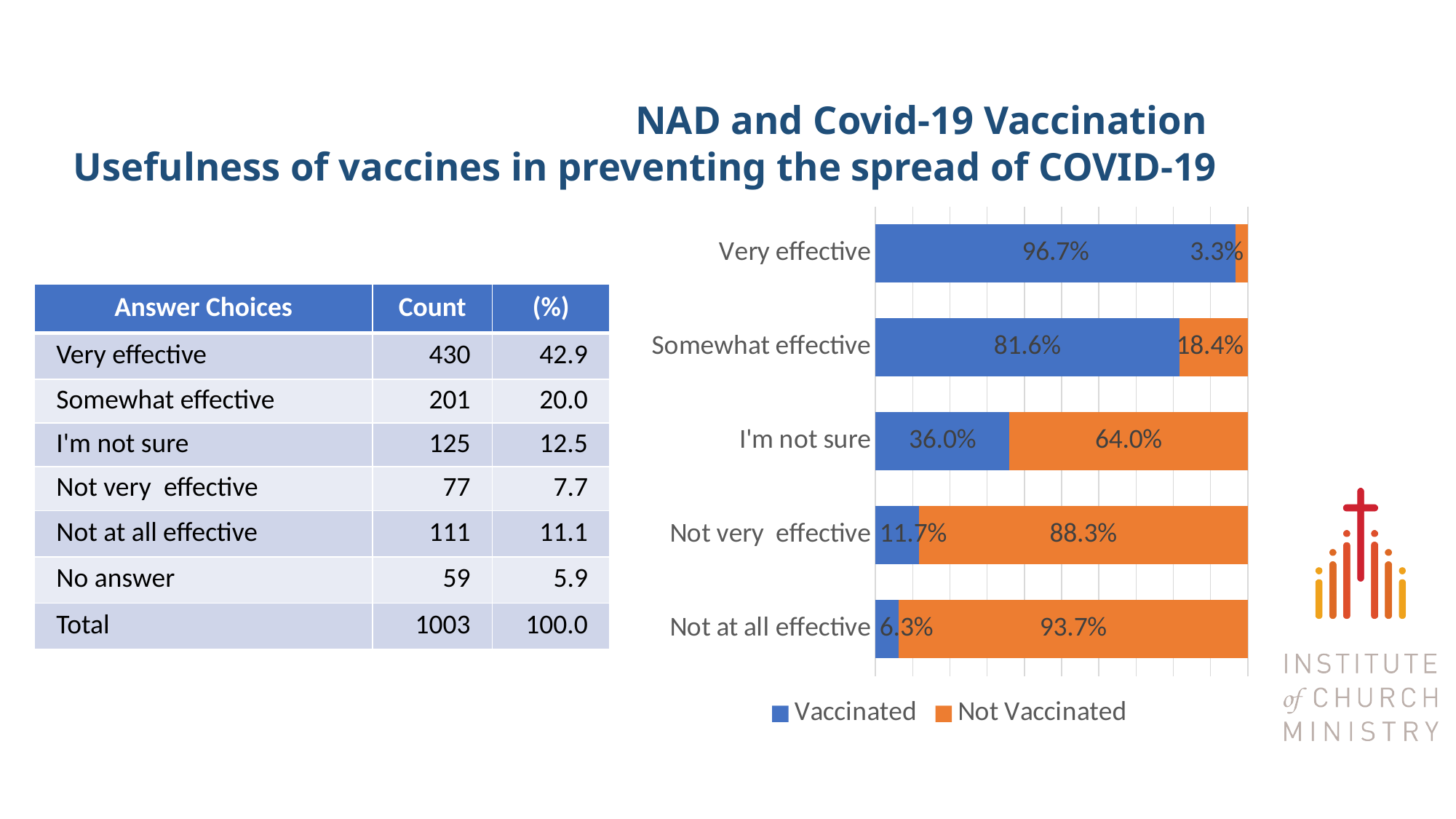
What is the Not Vaccinated value for "I'm not sure"? 64.0% What is the Not Vaccinated value for "Somewhat effective"? 18.4% How many series does the legend list? 2 What is the difference between the Vaccinated values for "Very effective" and "Somewhat effective"? 15.1% What kind of chart is shown on the slide? Stacked bar chart What is the Vaccinated value for "Very effective"? 96.7% What is the Vaccinated value for "Not very effective"? 11.7% Which category has the lowest Vaccinated value? Not at all effective Which is larger: the Vaccinated value for "I'm not sure" or the Not Vaccinated value for "I'm not sure"? Not Vaccinated What colour represents the Not Vaccinated series in the chart? Orange How many categories are shown in the chart? 5 Which category has the highest Not Vaccinated value? Not at all effective